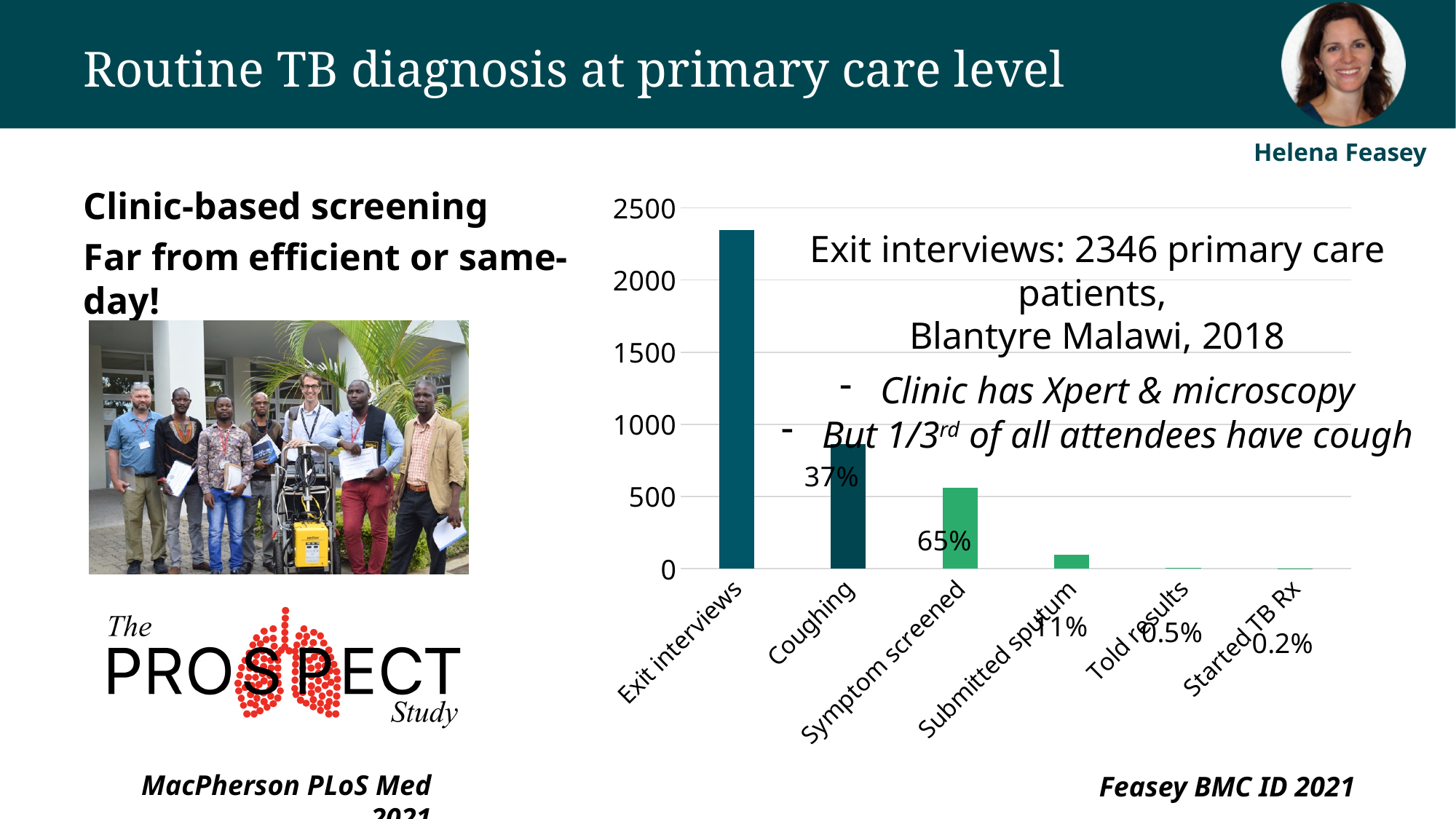
How many categories are shown on the x axis of the chart? 6 Is the value for Coughing greater or less than 1000? less Do the bar values rise or fall from left to right along the x axis? fall Which has a larger value, Submitted sputum or Symptom screened? Symptom screened What kind of chart is shown on the slide? bar chart Is the value for Exit interviews greater or less than 2000? greater According to the text on the chart, how many primary care patients had exit interviews? 2346 Which category has the highest bar in the chart? Exit interviews Which has a larger value, Coughing or Symptom screened? Coughing Is the value for Coughing greater or less than 500? greater What percentage label is shown next to the Symptom screened bar? 65%